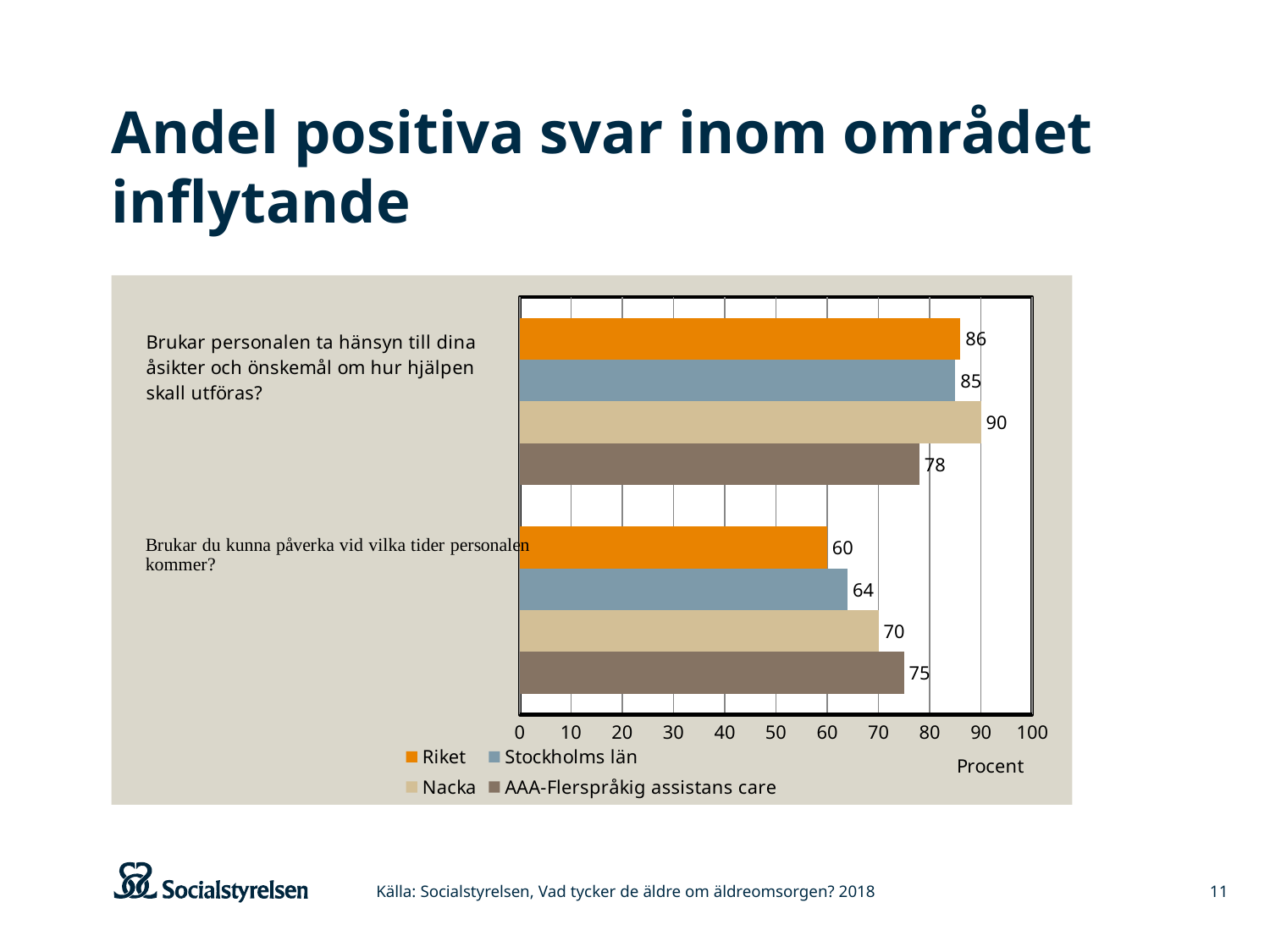
Which is larger for Stockholms län: the value for "Brukar personalen ta hänsyn till dina åsikter..." or for "Brukar du kunna påverka vid vilka tider personalen kommer?"? Brukar personalen ta hänsyn till dina åsikter och önskemål om hur hjälpen skall utföras? What colour represents Riket in the chart? Orange How many series does the legend list? 4 What is the label of the x axis? Procent What kind of chart is shown on the slide? Bar chart How many questions (categories) are shown on the chart? 2 Which series has the lowest value on the question "Brukar personalen ta hänsyn till dina åsikter och önskemål om hur hjälpen skall utföras?"? AAA-Flerspråkig assistans care Which series has the highest value on the question "Brukar du kunna påverka vid vilka tider personalen kommer?"? AAA-Flerspråkig assistans care What is the value for Nacka on the question "Brukar personalen ta hänsyn till dina åsikter och önskemål om hur hjälpen skall utföras?"? 90 What is the value for Riket on the question "Brukar du kunna påverka vid vilka tider personalen kommer?"? 60 What is the difference between Nacka and Stockholms län on the question "Brukar du kunna påverka vid vilka tider personalen kommer?"? 6 What is the value for AAA-Flerspråkig assistans care on the question "Brukar personalen ta hänsyn till dina åsikter och önskemål om hur hjälpen skall utföras?"? 78